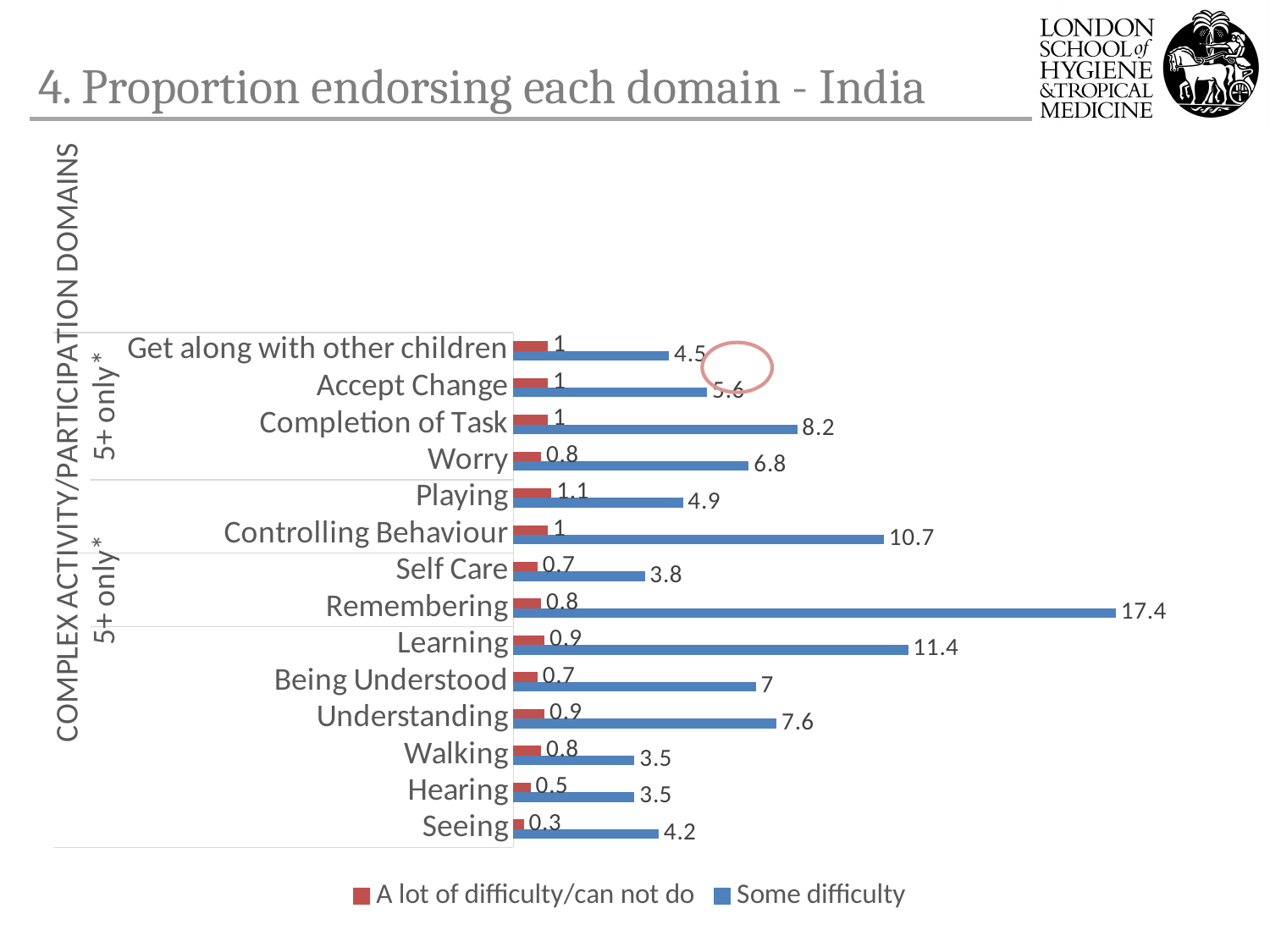
Which has a larger Some difficulty value, Controlling Behaviour or Completion of Task? Controlling Behaviour How many series does the legend list? 2 Which domain has the highest value for Some difficulty? Remembering How many domains are shown on the chart? 14 What is the difference between the Some difficulty values for Remembering and Learning? 6 What is the value for A lot of difficulty/can not do for Playing? 1.1 What is the value for Some difficulty for Controlling Behaviour? 10.7 What kind of chart is shown on the slide? Bar chart What is the value for Some difficulty for Remembering? 17.4 Which domain has the highest value for A lot of difficulty/can not do? Playing Which domain has the lowest value for A lot of difficulty/can not do? Seeing What is the value for A lot of difficulty/can not do for Seeing? 0.3